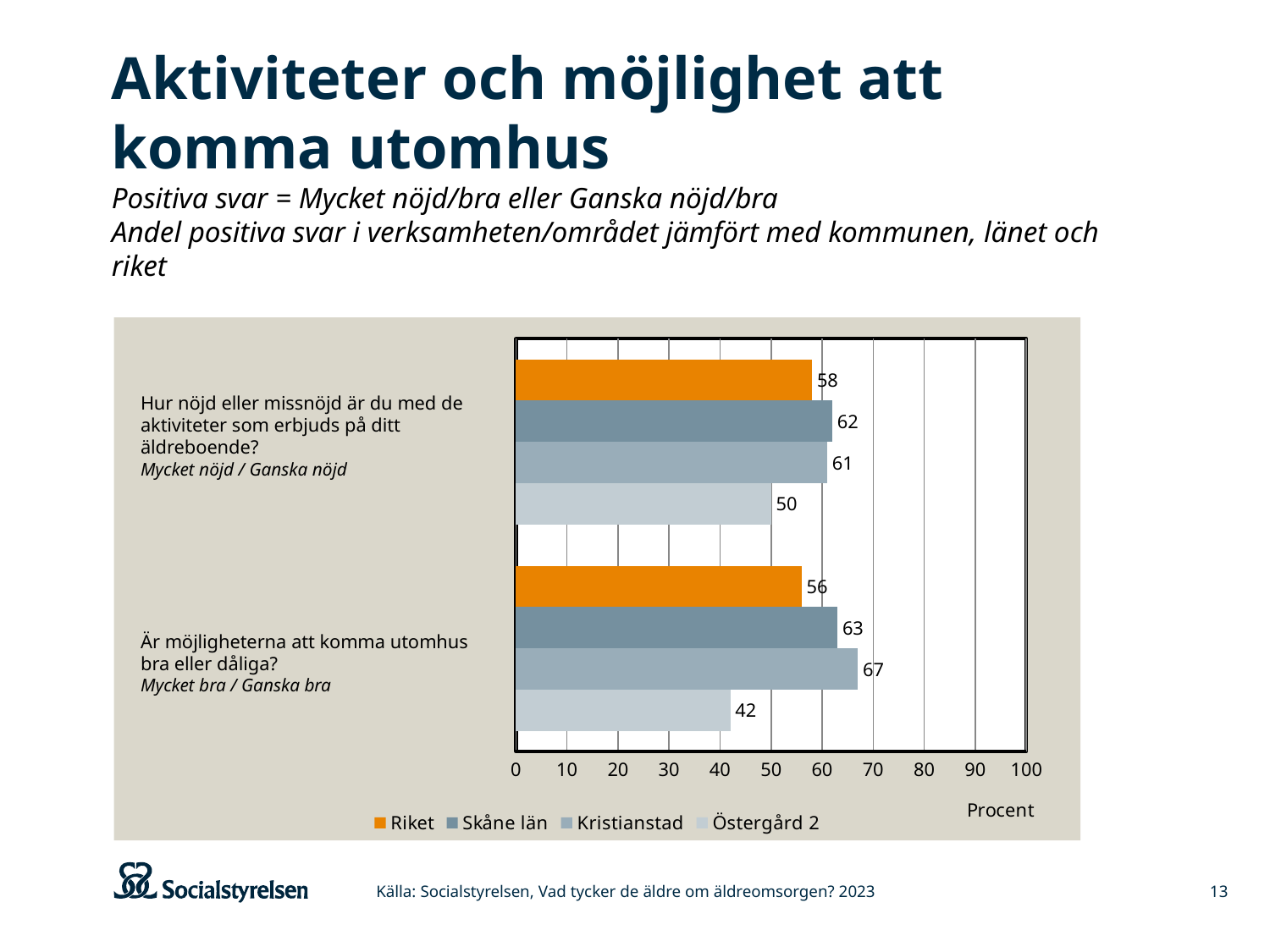
Which series has the highest value on the question "Är möjligheterna att komma utomhus bra eller dåliga?"? Kristianstad What is the value for Riket on the question "Är möjligheterna att komma utomhus bra eller dåliga?"? 56 Which series has the lowest value on the question "Hur nöjd eller missnöjd är du med de aktiviteter som erbjuds på ditt äldreboende?"? Östergård 2 How many survey questions (categories) are shown in the chart? 2 Which is larger on the question "Hur nöjd eller missnöjd är du med de aktiviteter som erbjuds på ditt äldreboende?": Riket or Skåne län? Skåne län What is the value for Kristianstad on the question "Är möjligheterna att komma utomhus bra eller dåliga?"? 67 What kind of chart is shown on the slide? Bar chart What is the value for Östergård 2 on the question "Hur nöjd eller missnöjd är du med de aktiviteter som erbjuds på ditt äldreboende?"? 50 How many series does the legend list? 4 What is the value for Skåne län on the question "Hur nöjd eller missnöjd är du med de aktiviteter som erbjuds på ditt äldreboende?"? 62 What is the difference between Kristianstad and Östergård 2 on the question "Är möjligheterna att komma utomhus bra eller dåliga?"? 25 What is the label of the x axis? Procent